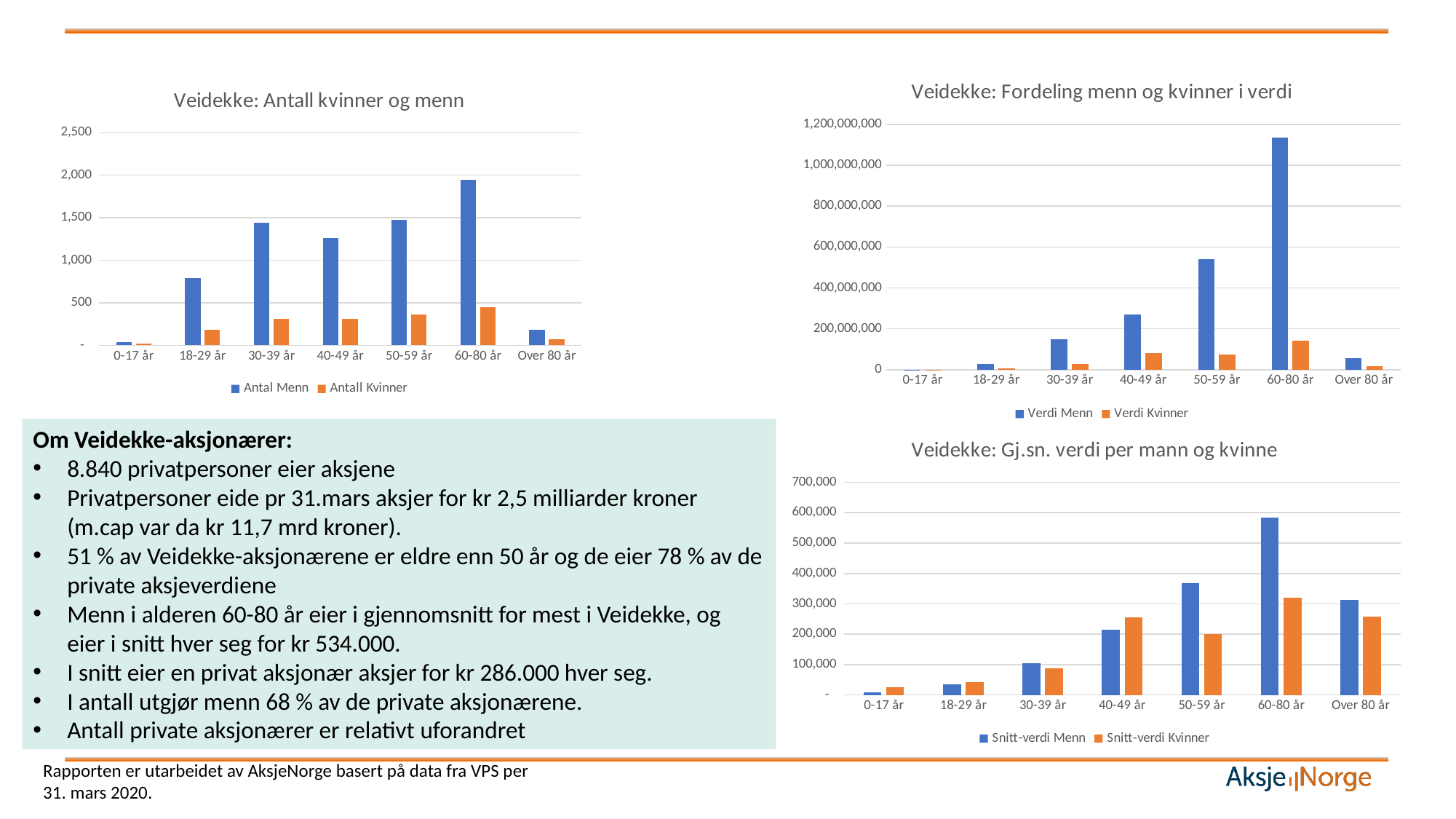
In the chart 'Veidekke: Antall kvinner og menn', how many age categories are shown on the x axis? 7 In the chart 'Veidekke: Gj.sn. verdi per mann og kvinne', which is larger for the 40-49 år group: Snitt-verdi Menn or Snitt-verdi Kvinner? Snitt-verdi Kvinner In the chart 'Veidekke: Gj.sn. verdi per mann og kvinne', which age group has the highest value for Snitt-verdi Kvinner? 60-80 år In the chart 'Veidekke: Fordeling menn og kvinner i verdi', which age group has the highest value for Verdi Menn? 60-80 år In the chart 'Veidekke: Antall kvinner og menn', is the value for Antall Kvinner in the 30-39 år group greater or less than 500? less In the chart 'Veidekke: Gj.sn. verdi per mann og kvinne', is the value for Snitt-verdi Menn in the 60-80 år group greater or less than 500,000? greater In the chart 'Veidekke: Antall kvinner og menn', which age group has the highest value for Antal Menn? 60-80 år In the chart 'Veidekke: Antall kvinner og menn', is the value for Antal Menn in the 60-80 år group greater or less than 1,500? greater In the chart 'Veidekke: Antall kvinner og menn', which age group has the lowest value for Antal Menn? 0-17 år What kind of chart is 'Veidekke: Gj.sn. verdi per mann og kvinne'? bar chart In the chart 'Veidekke: Fordeling menn og kvinner i verdi', how many series does the legend list? 2